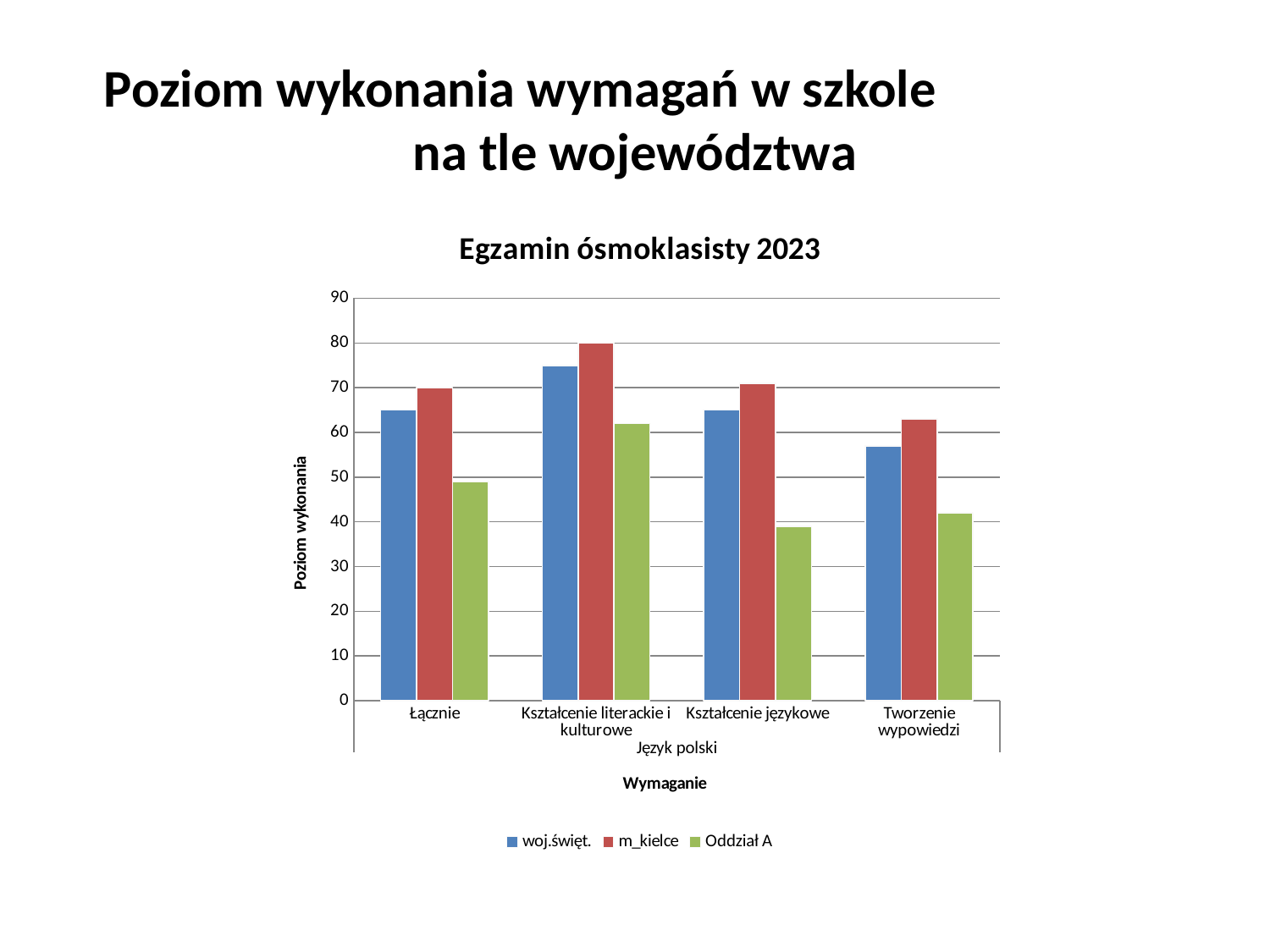
For the Oddział A series, which category has the lowest value? Kształcenie językowe Is the value for woj.święt. in Tworzenie wypowiedzi greater or less than 60? less What kind of chart is shown on the slide? bar chart For the woj.święt. series, which category has the highest value? Kształcenie literackie i kulturowe What is the title of the chart? Egzamin ósmoklasisty 2023 How many categories are shown on the x axis? 4 For the m_kielce series, which category has the highest value? Kształcenie literackie i kulturowe In the Łącznie category, which is larger: woj.święt. or Oddział A? woj.święt. In the Tworzenie wypowiedzi category, which is larger: m_kielce or woj.święt.? m_kielce Is the value for m_kielce in Kształcenie literackie i kulturowe greater or less than 70? greater How many series does the legend list? 3 Is the value for Oddział A in Kształcenie językowe greater or less than 50? less